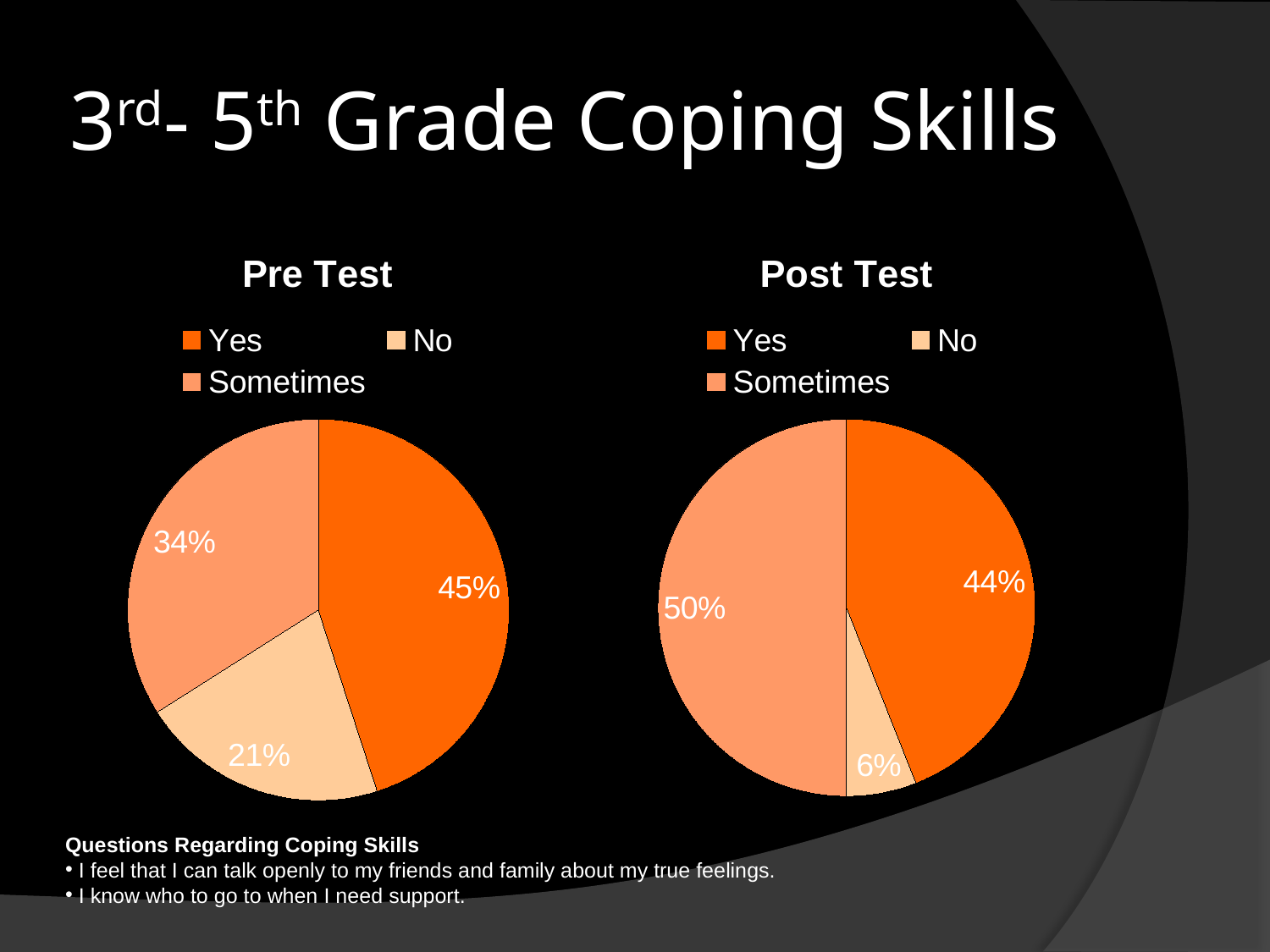
In the Post Test chart, what percentage is shown for Sometimes? 50% In the Pre Test chart, what percentage is shown for No? 21% What is the title of the chart on the right side of the slide? Post Test In the Post Test chart, which category has the smallest slice? No In the Post Test chart, which is larger, Yes or Sometimes? Sometimes How many slices does the Pre Test pie chart have? 3 In the Pre Test chart, what percentage is shown for Yes? 45% What type of chart is the Pre Test chart? Pie chart How many entries does the legend of the Post Test chart list? 3 In the Pre Test chart, which category has the largest slice? Yes In the Post Test chart, what percentage is shown for No? 6% What is the difference between the No percentages in the Pre Test and Post Test charts? 15%